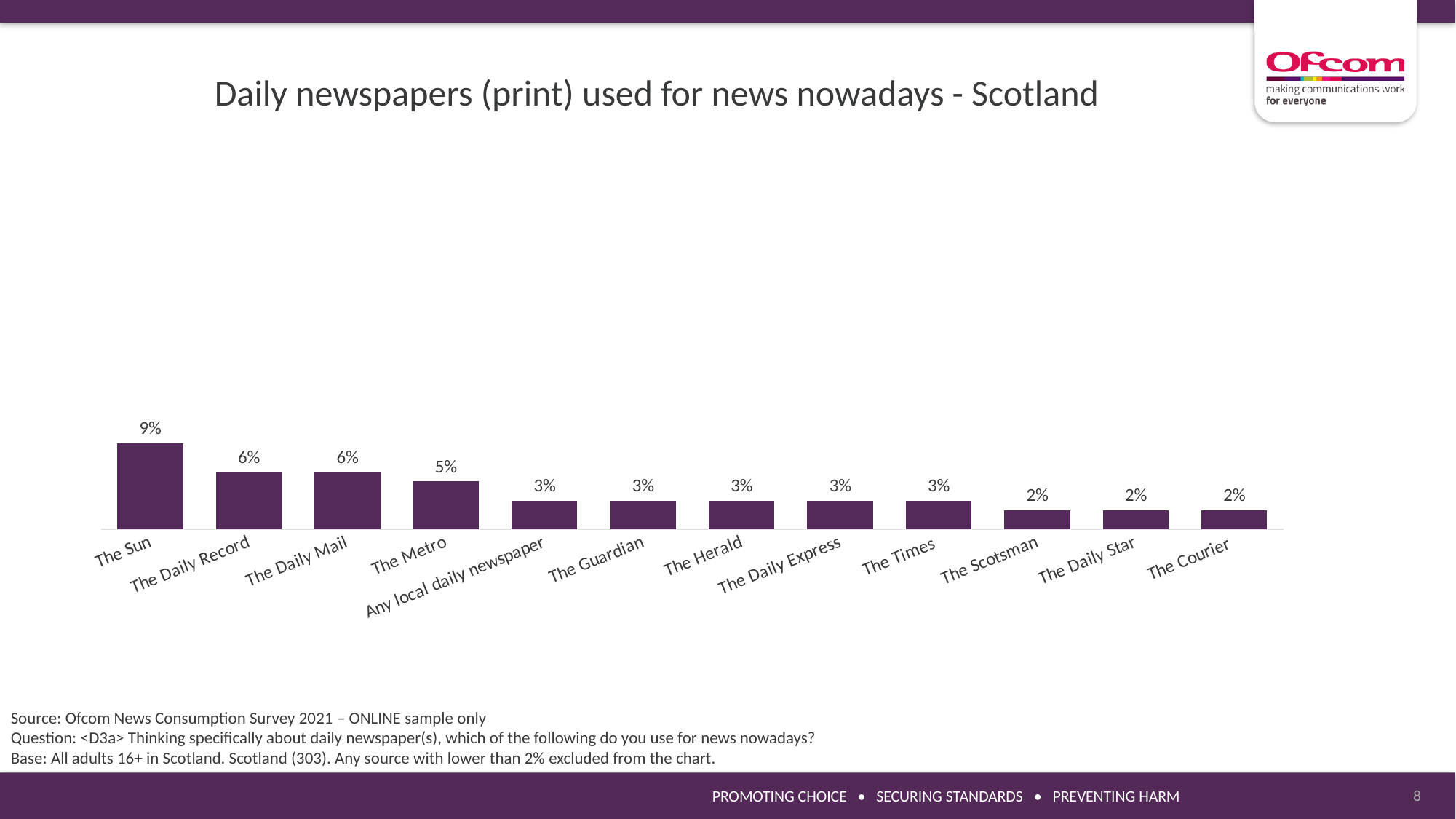
What is the difference between the values for The Metro and The Courier? 3% How many newspapers/categories are shown on the chart? 12 Which has a larger value, The Daily Mail or The Guardian? The Daily Mail Which newspaper has the highest value on the chart? The Sun What is the value shown for The Metro? 5% What is the difference between the values for The Sun and The Daily Record? 3% What is the value shown for Any local daily newspaper? 3% Do the values rise or fall moving from left to right along the x axis? Fall What kind of chart is shown on the slide? Bar chart What percentage of adults in Scotland use The Sun for news nowadays? 9% What is the value shown for The Scotsman? 2% Which has a larger value, The Times or The Daily Star? The Times